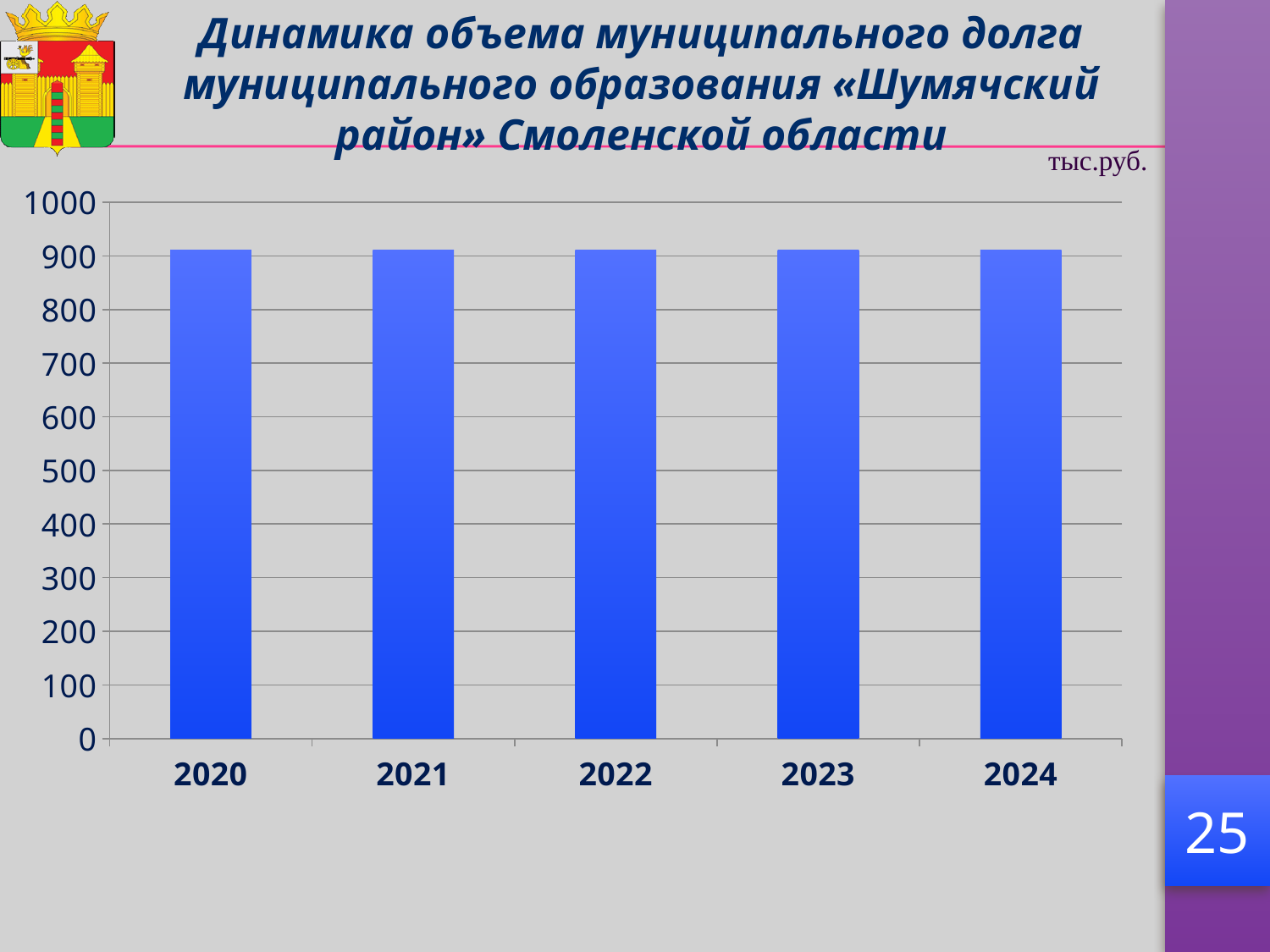
Is the value for 2024 greater or less than 500? greater Is the value for 2021 greater or less than 700? greater What unit is indicated above the chart? тыс.руб. What kind of chart is shown on the slide? bar chart Do the values rise, fall, or stay the same from 2020 to 2024? stay the same Is the value for 2020 greater or less than 800? greater What is the first year shown on the x axis? 2020 How many years are shown on the x axis of the chart? 5